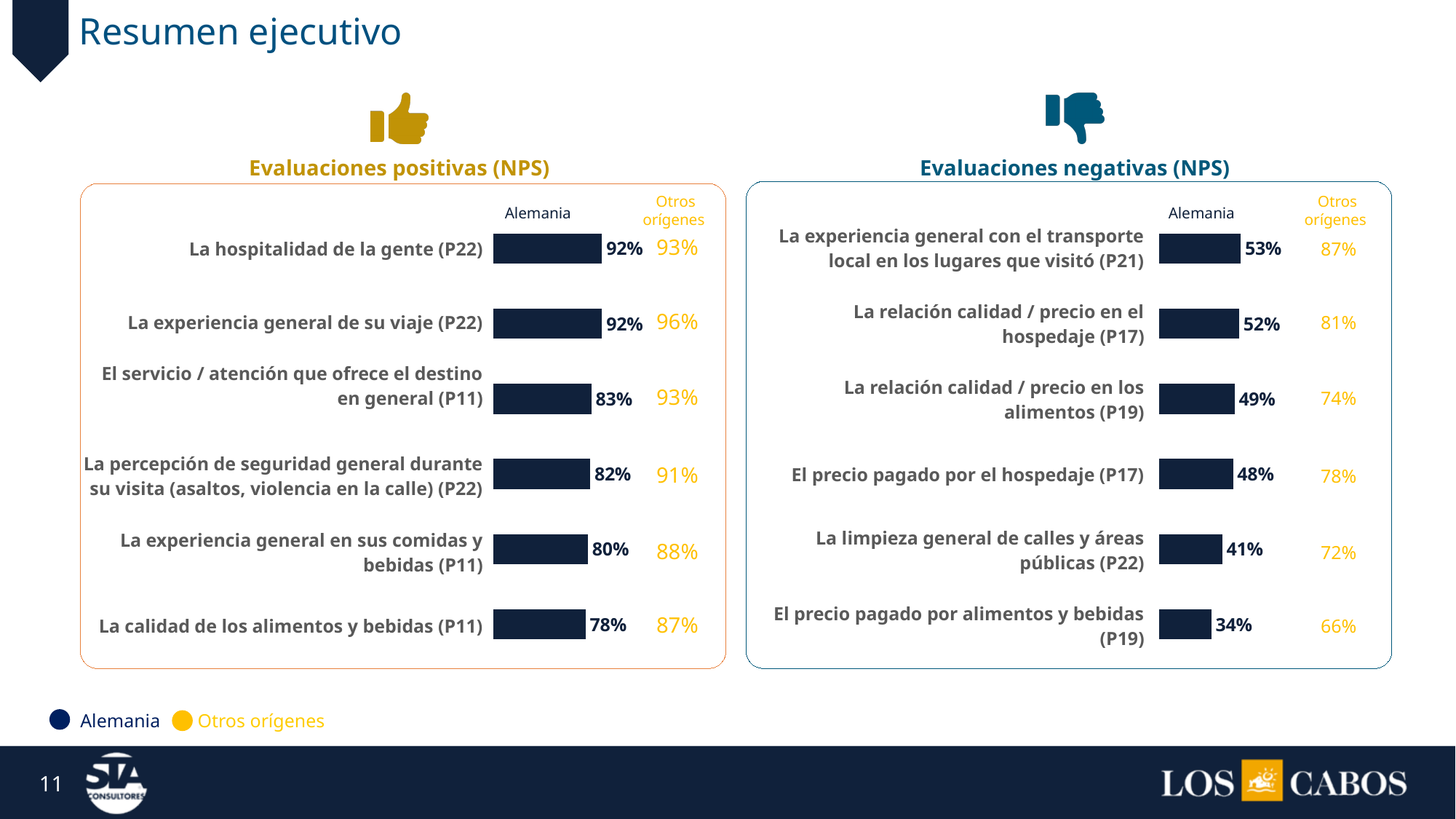
In the 'Evaluaciones negativas (NPS)' chart, which category has the highest Alemania value? La experiencia general con el transporte local en los lugares que visitó (P21) In the 'Evaluaciones positivas (NPS)' chart, what is the Alemania value for 'La hospitalidad de la gente (P22)'? 92% What kind of chart is used in the 'Evaluaciones negativas (NPS)' panel? Bar chart In the 'Evaluaciones negativas (NPS)' chart, what is the difference between the 'Otros orígenes' and Alemania values for 'La relación calidad / precio en el hospedaje (P17)'? 29% How many categories are shown in the 'Evaluaciones positivas (NPS)' chart? 6 In the 'Evaluaciones negativas (NPS)' chart, what is the 'Otros orígenes' value for 'La limpieza general de calles y áreas públicas (P22)'? 72% In the 'Evaluaciones negativas (NPS)' chart, which is larger for 'El precio pagado por alimentos y bebidas (P19)': the Alemania value or the 'Otros orígenes' value? Otros orígenes In the 'Evaluaciones negativas (NPS)' chart, what is the Alemania value for 'El precio pagado por el hospedaje (P17)'? 48% How many series does the legend at the bottom of the slide list? 2 In the 'Evaluaciones positivas (NPS)' chart, which category has the lowest Alemania value? La calidad de los alimentos y bebidas (P11) In the 'Evaluaciones positivas (NPS)' chart, what is the 'Otros orígenes' value for 'La experiencia general de su viaje (P22)'? 96% In the 'Evaluaciones positivas (NPS)' chart, what is the difference between the 'Otros orígenes' and Alemania values for 'La calidad de los alimentos y bebidas (P11)'? 9%